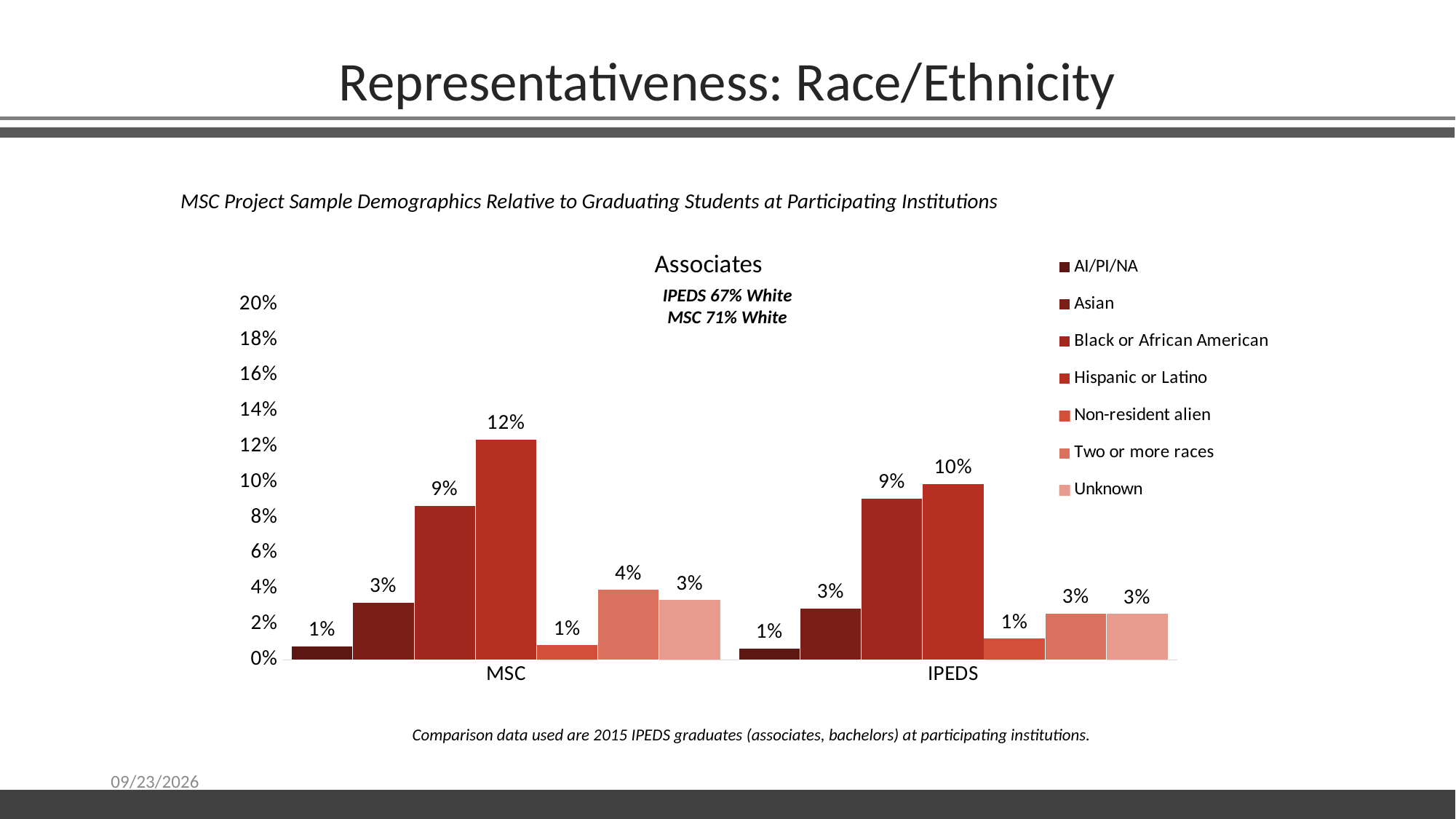
According to the text on the chart, what percentage of the MSC sample is White? 71% How many categories are shown on the x axis? 2 What is the difference between the Hispanic or Latino values for MSC and IPEDS? 2% What is the value for Hispanic or Latino in the MSC group? 12% What kind of chart is shown on the slide? Bar chart Which series has the highest value in the MSC group? Hispanic or Latino What is the value for Hispanic or Latino in the IPEDS group? 10% What is the value for Black or African American in the IPEDS group? 9% How many series does the legend list? 7 Which is larger, the Two or more races value for MSC or for IPEDS? MSC What is the title of the chart? Associates What is the value for Two or more races in the MSC group? 4%